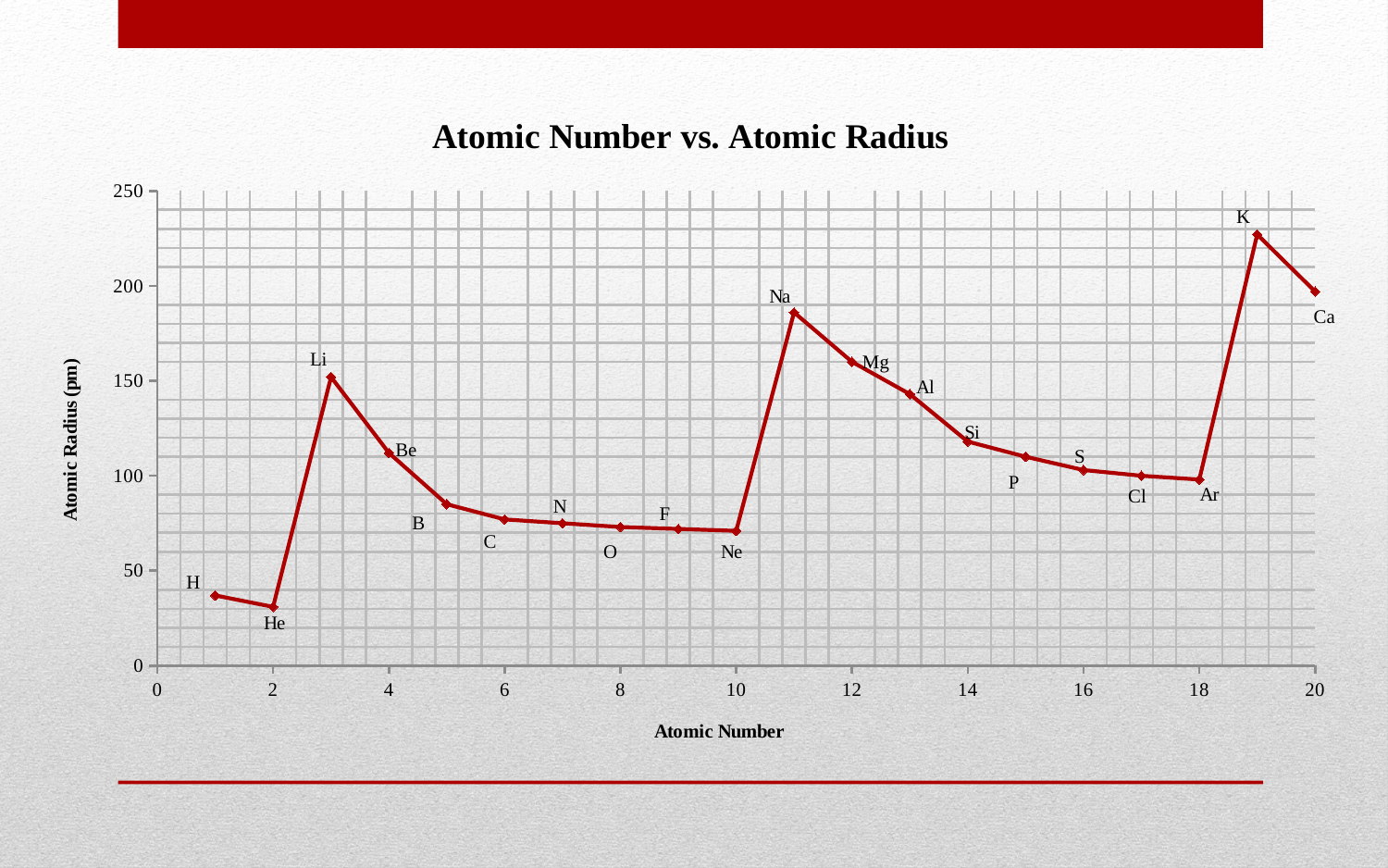
What is the label of the vertical axis? Atomic Radius (pm) Is the atomic radius for Ne greater or less than 100? less What kind of chart is shown on the slide? line chart What is the title of the chart? Atomic Number vs. Atomic Radius How many data points are plotted on the chart? 20 Is the atomic radius for Na greater or less than 150? greater Is the atomic radius for H greater or less than 50? less Which has the larger atomic radius, Na or Mg? Na Which element has the lowest atomic radius on the chart? He Do the values rise or fall from Li (atomic number 3) to Ne (atomic number 10)? fall Which element has the highest atomic radius on the chart? K